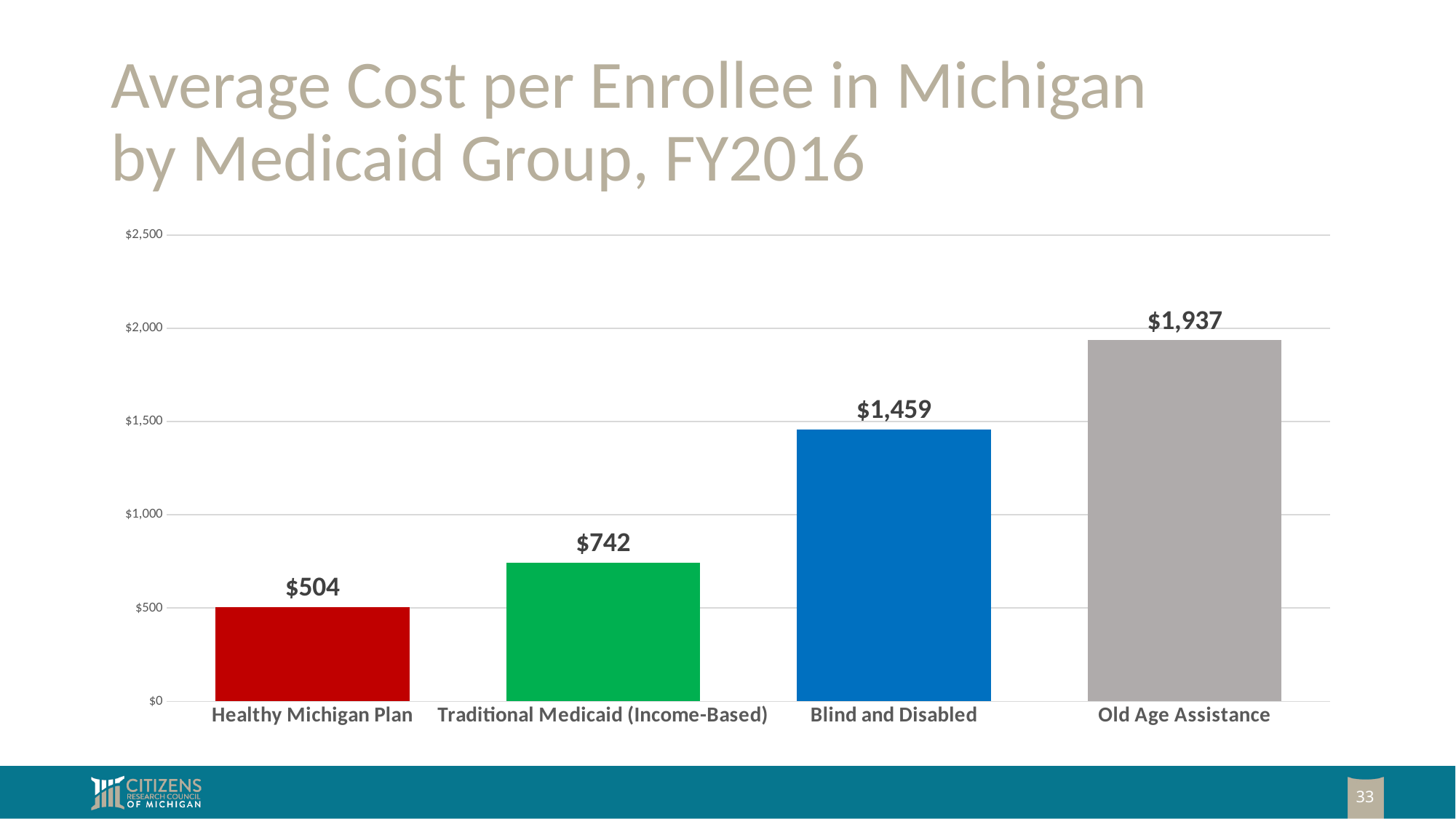
What is the average cost per enrollee for Old Age Assistance? $1,937 Which Medicaid group has the lowest average cost per enrollee? Healthy Michigan Plan Is the value for Old Age Assistance greater or less than $1,500? greater What is the average cost per enrollee for Traditional Medicaid (Income-Based)? $742 Which Medicaid group has the highest average cost per enrollee? Old Age Assistance What is the difference in average cost per enrollee between Old Age Assistance and Blind and Disabled? $478 Which has a higher average cost per enrollee, Blind and Disabled or Traditional Medicaid (Income-Based)? Blind and Disabled What kind of chart is shown on the slide? Bar chart What is the average cost per enrollee for the Healthy Michigan Plan? $504 How many Medicaid groups are shown in the chart? 4 What is the average cost per enrollee for Blind and Disabled? $1,459 What is the difference in average cost per enrollee between Traditional Medicaid (Income-Based) and the Healthy Michigan Plan? $238